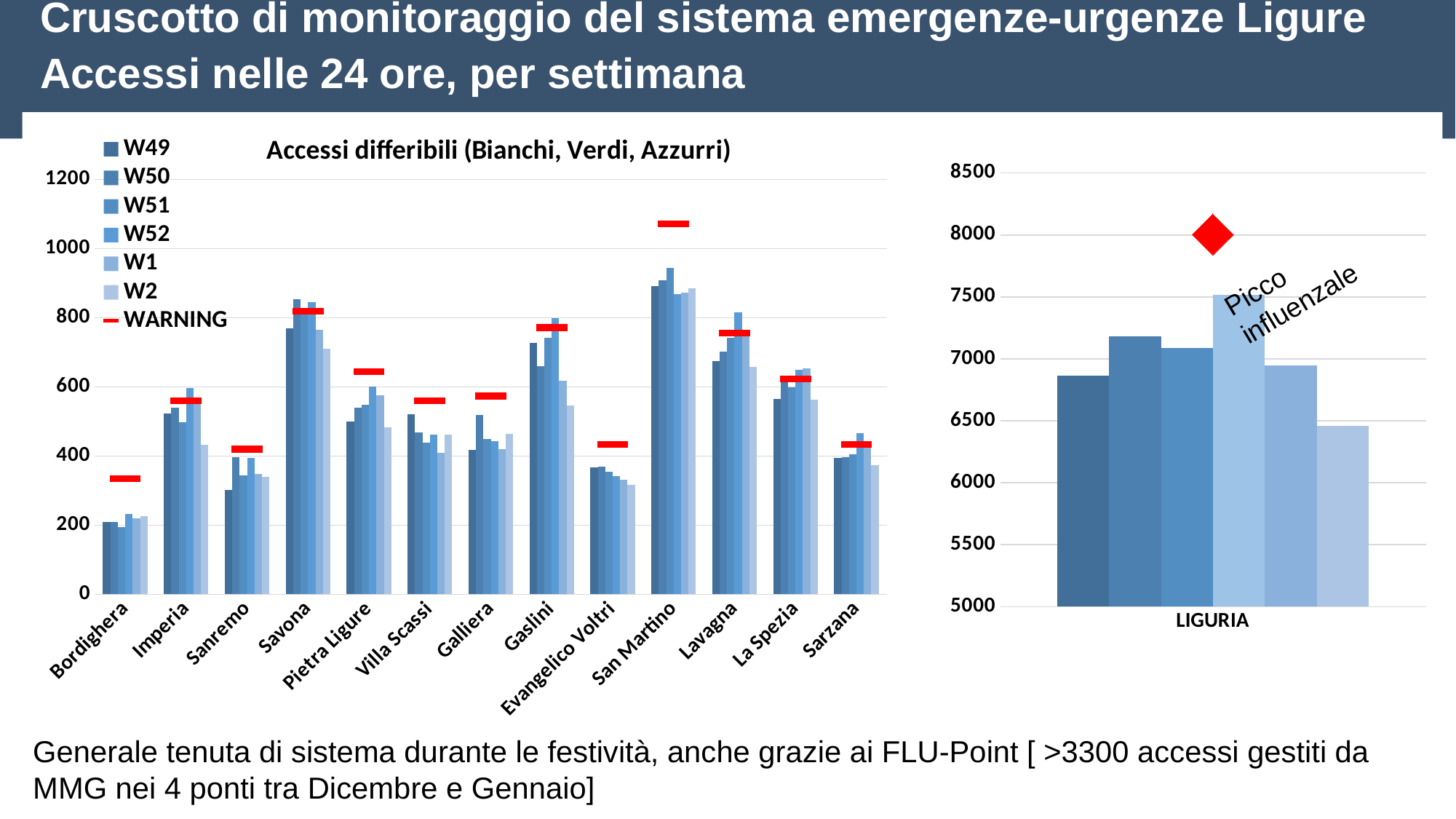
In the left chart 'Accessi differibili', how many hospital categories are shown on the x axis? 13 In the left chart 'Accessi differibili', which category has the lowest bars? Bordighera In the left chart 'Accessi differibili', are the values for Bordighera greater or less than 400? less What kind of chart is the right chart with the category LIGURIA? Bar chart In the right chart with the category LIGURIA, is the value of the tallest bar greater or less than 7000? greater In the left chart 'Accessi differibili', are the values for San Martino greater or less than 800? greater In the left chart 'Accessi differibili', which category has larger values, Savona or Imperia? Savona In the left chart 'Accessi differibili', which category has the highest bars? San Martino In the left chart 'Accessi differibili', what colour are the WARNING markers? Red In the right chart with the category LIGURIA, how many bars are shown? 6 What kind of chart is the left chart titled 'Accessi differibili (Bianchi, Verdi, Azzurri)'? Bar chart In the left chart 'Accessi differibili', how many entries does the legend list? 7